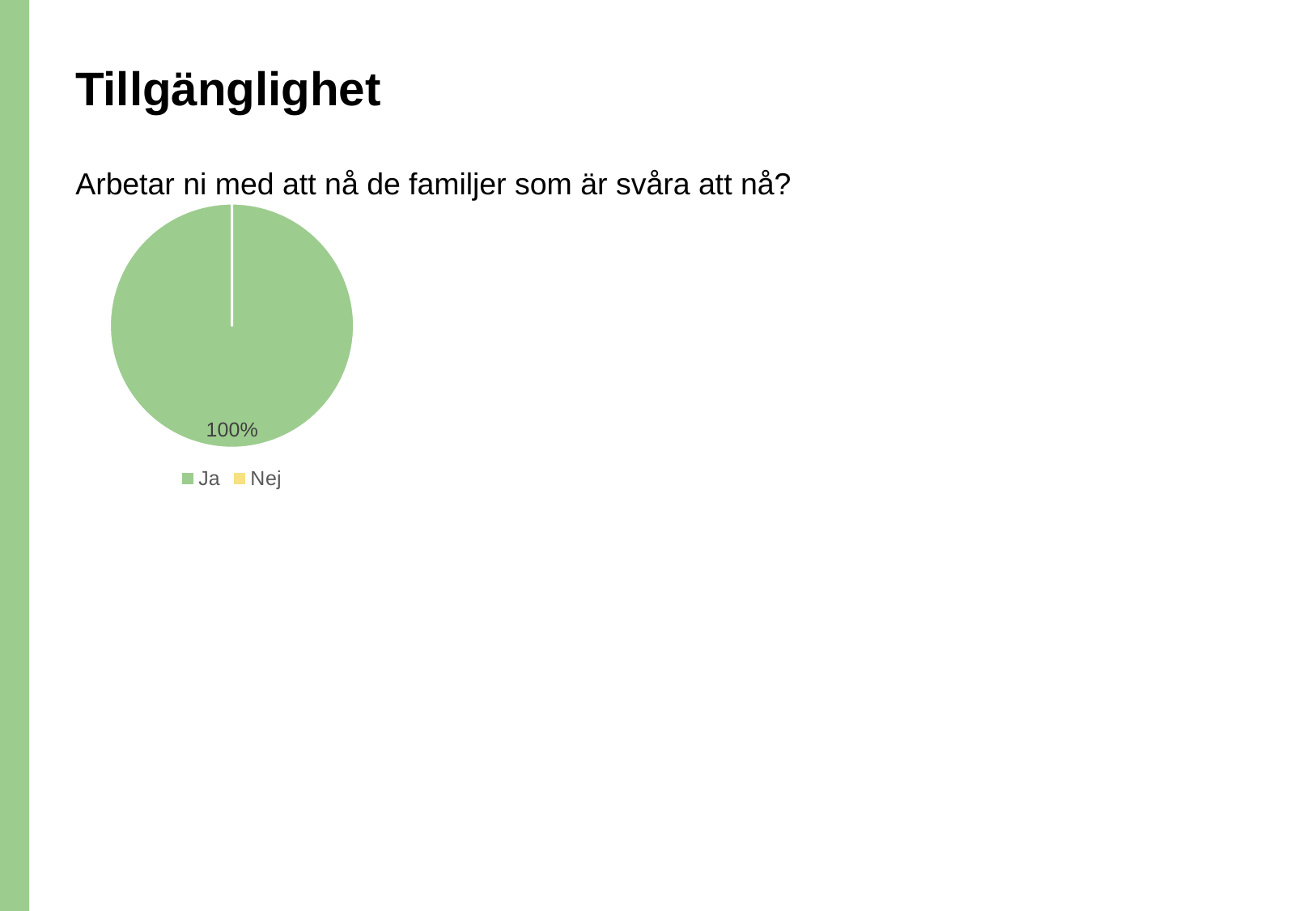
What are the two categories listed in the legend? Ja and Nej How many entries does the legend list? 2 What colour is the "Ja" slice in the pie chart? green Which category has the smallest share of the pie? Nej What value is printed as the data label on the pie chart? 100% Which category has the largest share of the pie? Ja What kind of chart is shown on the slide? pie chart Which is larger, the share for "Ja" or the share for "Nej"? Ja What question does the pie chart answer, according to the text above it? Arbetar ni med att nå de familjer som är svåra att nå? What share of the pie does "Ja" account for? 100%